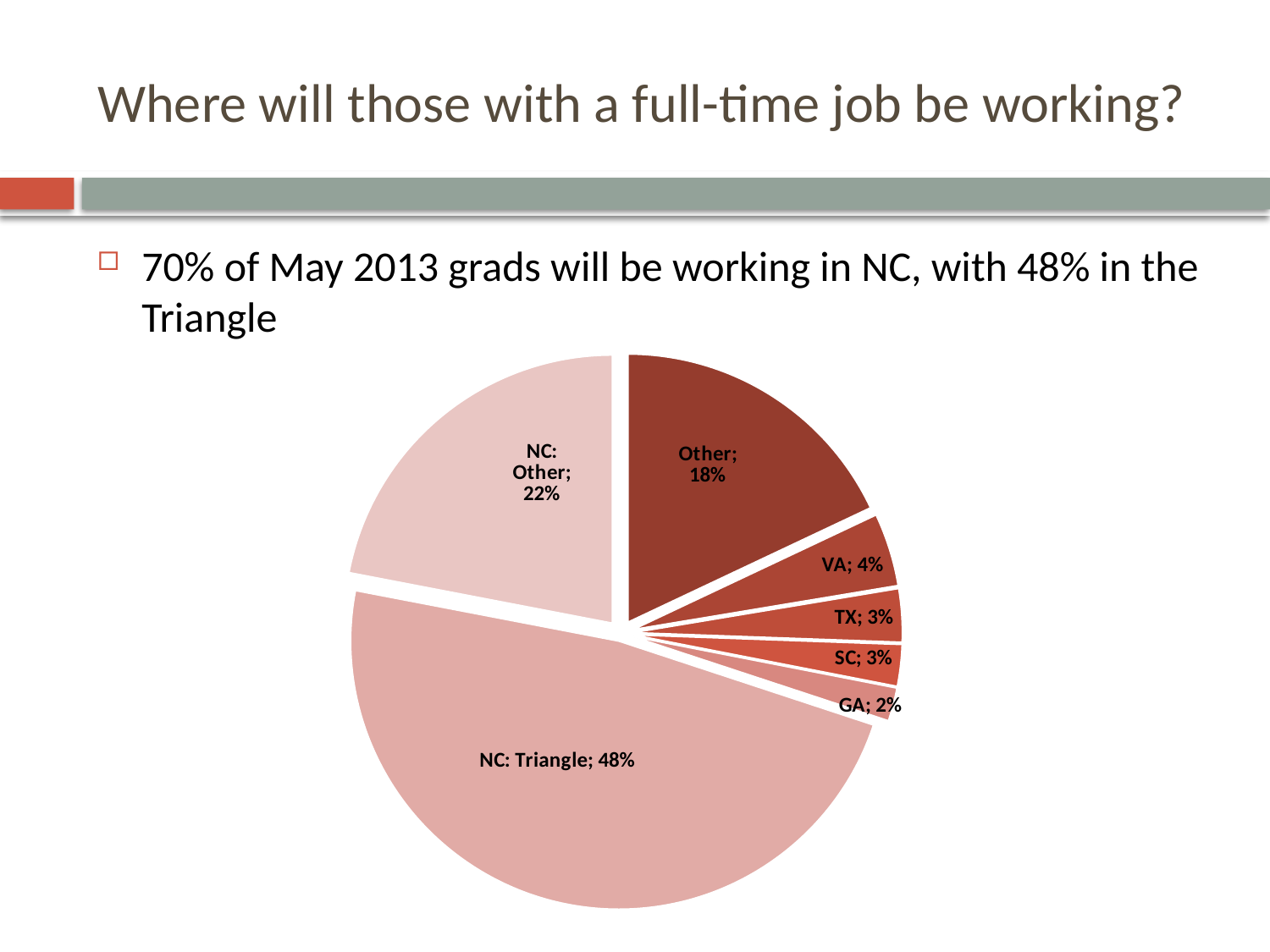
Which slice of the pie is the smallest? GA Which is larger, the share for VA or the share for TX? VA Which slice of the pie is the largest? NC: Triangle What kind of chart is shown on the slide? pie chart What is the difference between the NC: Triangle share and the NC: Other share? 26% What is the combined share of NC: Triangle and NC: Other? 70% What share of the pie is VA? 4% How many slices does the pie chart have? 7 What share of the pie is Other? 18% What share of the pie is NC: Other? 22% What share of the pie is GA? 2% What share of the pie is NC: Triangle? 48%